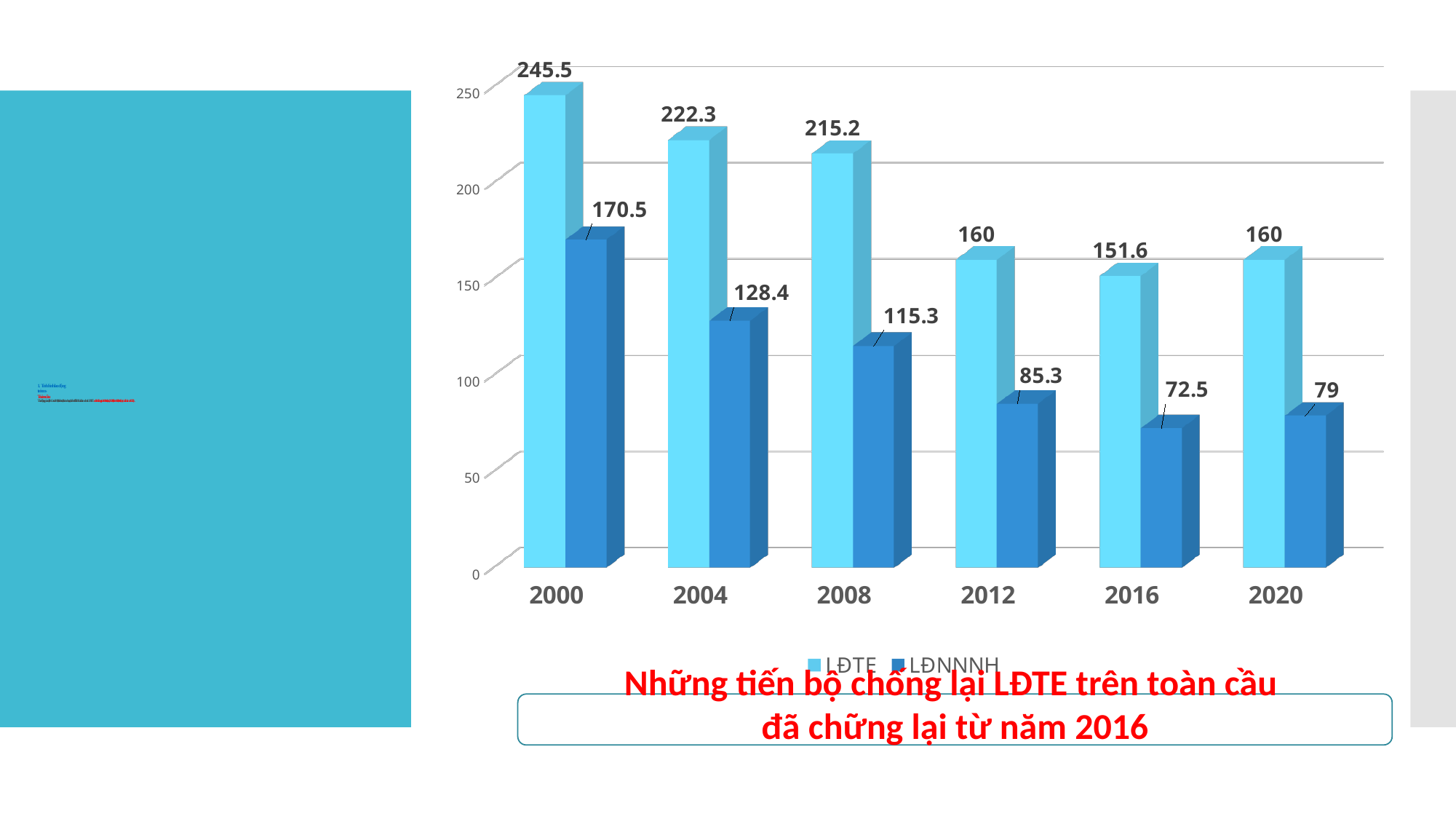
Which year has the lowest LĐNNNH value? 2016 How many years are shown on the x axis? 6 What kind of chart is shown on the slide? bar chart Does the LĐNNNH series generally rise or fall from 2000 to 2016? fall What is the LĐNNNH value for 2008? 115.3 Which is larger, the LĐNNNH value for 2004 or for 2012? 2004 What is the difference between the LĐTE and LĐNNNH values in 2020? 81 What is the LĐTE value for 2000? 245.5 Which year has the highest LĐTE value? 2000 How many series does the legend list? 2 What is the LĐNNNH value for 2016? 72.5 What is the difference between the LĐTE values for 2000 and 2004? 23.2